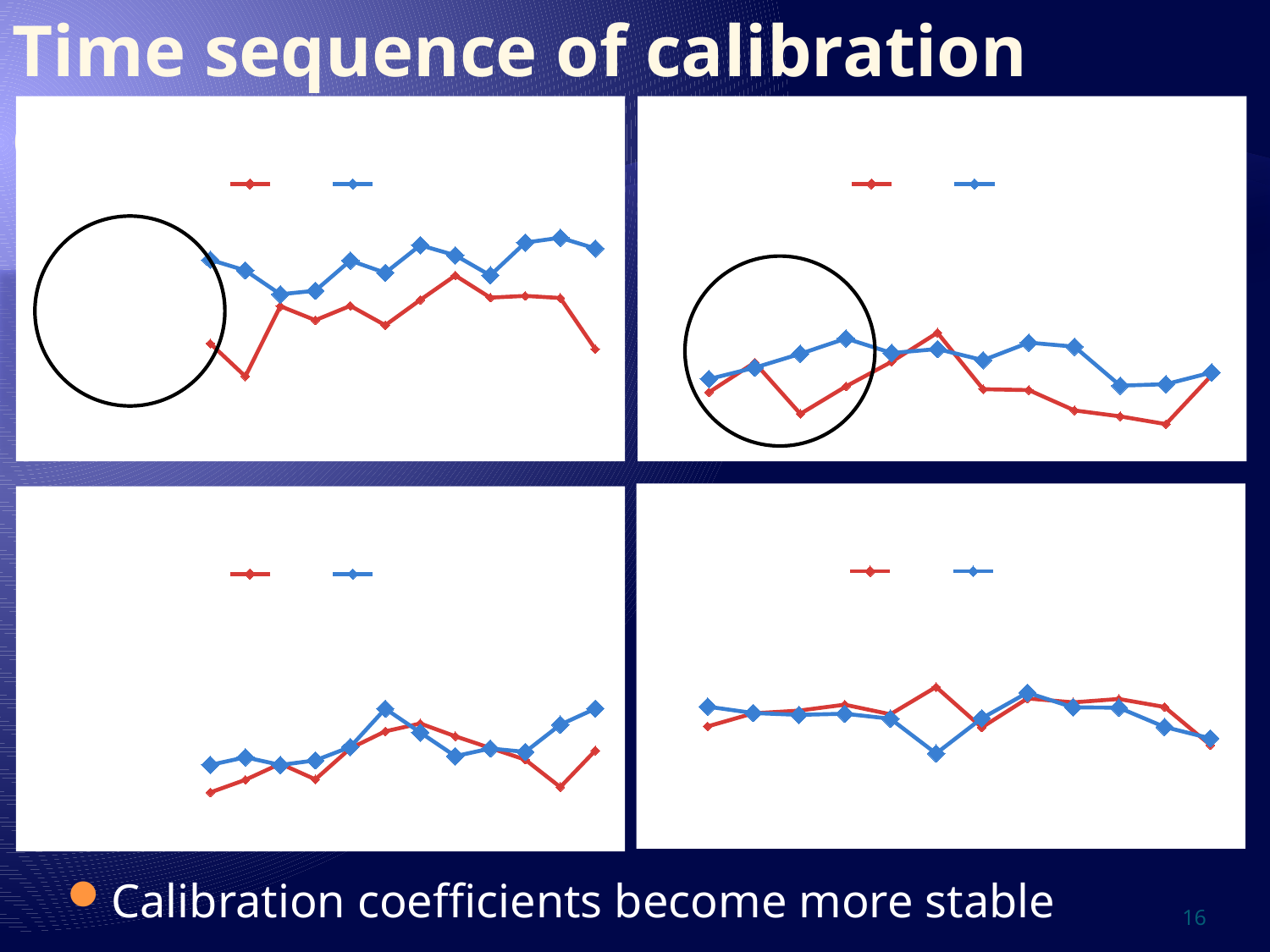
How many data points does the red series in the bottom-right chart have? 12 What kind of chart is the top-left chart? line chart How many series does the legend of the top-left chart list? 2 In the top-left chart, at the last point on the right, which series has the higher value, red or blue? blue What two colours are used for the series in the bottom-left chart? red and blue How many series does the legend of the bottom-right chart list? 2 In the bottom-right chart, at the seventh point from the left, which series has the higher value, red or blue? blue In the top-left chart, at the first point on the left, which series has the higher value, red or blue? blue What kind of chart is the bottom-right chart? line chart How many data points does the blue series in the top-left chart have? 12 How many charts are shown on the slide? 4